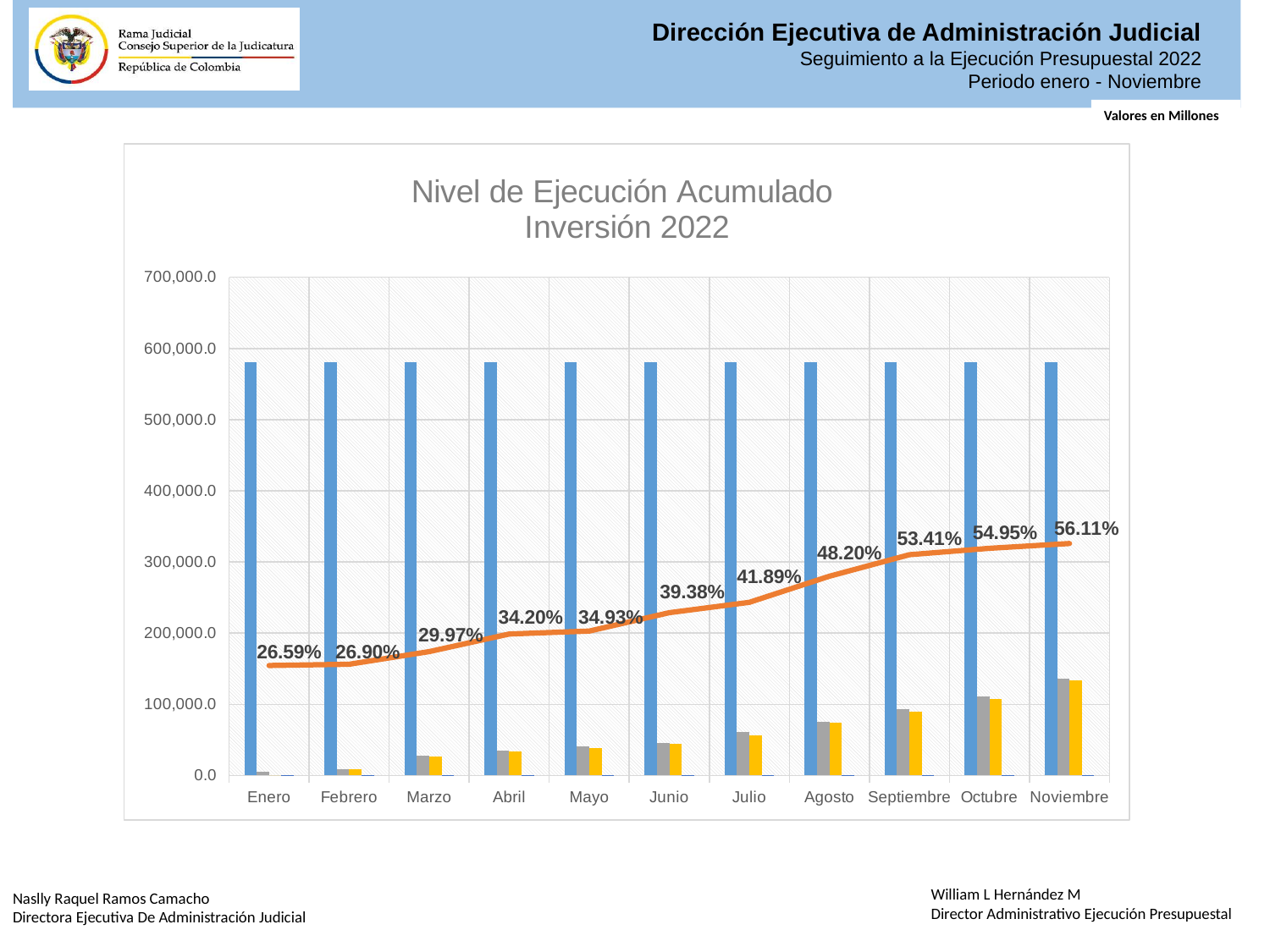
What is the difference between the percentage labels for Noviembre and Enero? 29.52% What is the percentage label shown for Junio on the line in the chart? 39.38% What is the percentage label shown for Enero on the line in the chart? 26.59% What is the percentage label shown for Septiembre on the line in the chart? 53.41% Which month has the highest percentage label on the line? Noviembre Which has a higher percentage label, Julio or Agosto? Agosto Which month has the lowest percentage label on the line? Enero How many months are shown on the x axis of the chart? 11 Is the value of the tall blue bar for Enero greater or less than 500,000.0? greater What is the percentage label shown for Noviembre on the line in the chart? 56.11% Do the percentage values on the line rise or fall from Enero to Noviembre? rise What is the title of the chart? Nivel de Ejecución Acumulado Inversión 2022